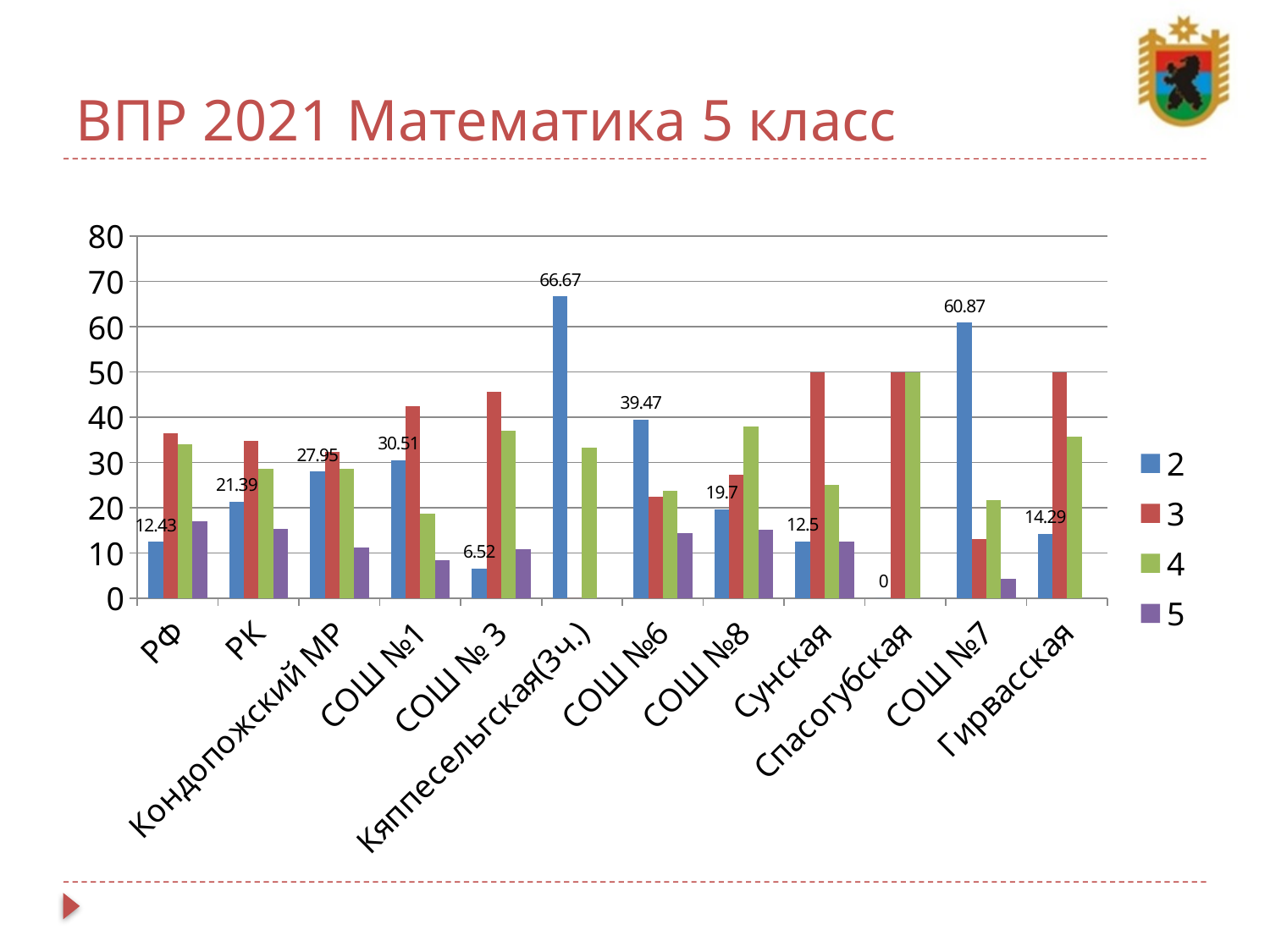
What is the value of series "2" for Кяппесельгская(3ч.)? 66.67 Which is larger for series "2": СОШ №6 or СОШ №8? СОШ №6 Is the value of series "3" for СОШ № 3 greater or less than 40? greater How many categories are shown on the x axis? 12 What is the value of series "2" for СОШ №7? 60.87 What is the value of series "2" for Спасогубская? 0 What type of chart is shown on the slide? Bar chart Which category has the lowest value for series "2"? Спасогубская What is the value of series "2" for РФ? 12.43 Which category has the highest value for series "2"? Кяппесельгская(3ч.) How many series does the legend list? 4 What is the difference between the series "2" values for Кяппесельгская(3ч.) and СОШ №7? 5.8